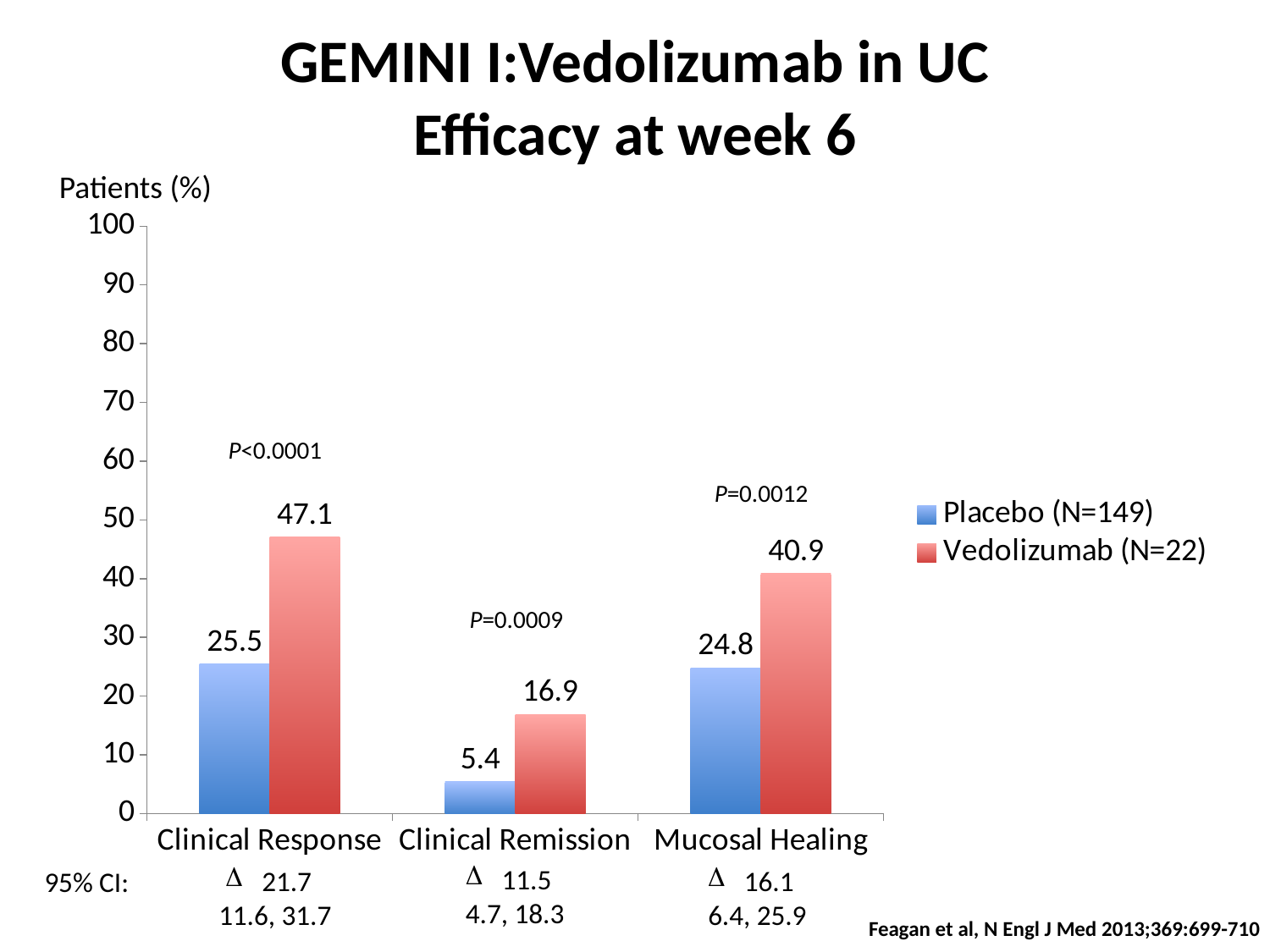
What is the label of the y axis? Patients (%) How many series does the legend list? 2 What is the value for Placebo in the Clinical Remission category? 5.4 Which category has the highest Vedolizumab value? Clinical Response What is the value for Vedolizumab in the Mucosal Healing category? 40.9 What kind of chart is shown on the slide? bar chart How many categories are shown on the x axis? 3 What is the difference between the Vedolizumab and Placebo values for Clinical Remission? 11.5 Which category has the lowest Placebo value? Clinical Remission What is the value for Vedolizumab in the Clinical Response category? 47.1 Which is larger in the Mucosal Healing category, Placebo or Vedolizumab? Vedolizumab Is the Placebo value for Clinical Response greater or less than 30? less